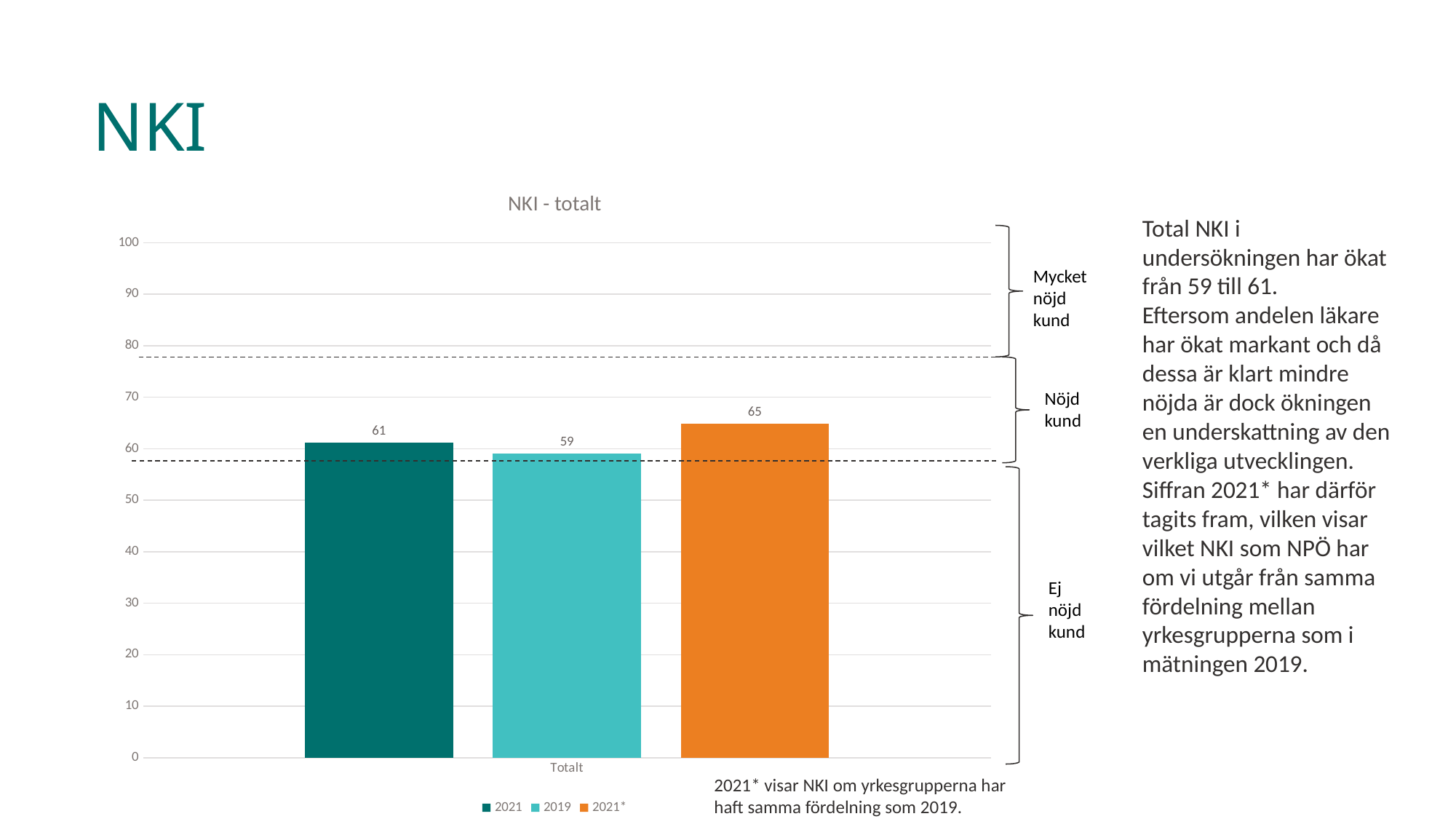
What kind of chart is shown on the slide? bar chart Which series has the highest value in the NKI - totalt chart? 2021* Which is larger, the value for 2021 or the value for 2019? 2021 What is the difference between the 2021 value and the 2019 value? 2 What is the value for the 2021 series in the NKI - totalt chart? 61 What is the value for the 2019 series in the NKI - totalt chart? 59 Is the value for 2021* greater or less than 60? greater What is the difference between the 2021* value and the 2019 value? 6 How many series does the legend list? 3 What is the title of the chart? NKI - totalt Which series has the lowest value in the NKI - totalt chart? 2019 What is the value for the 2021* series in the NKI - totalt chart? 65